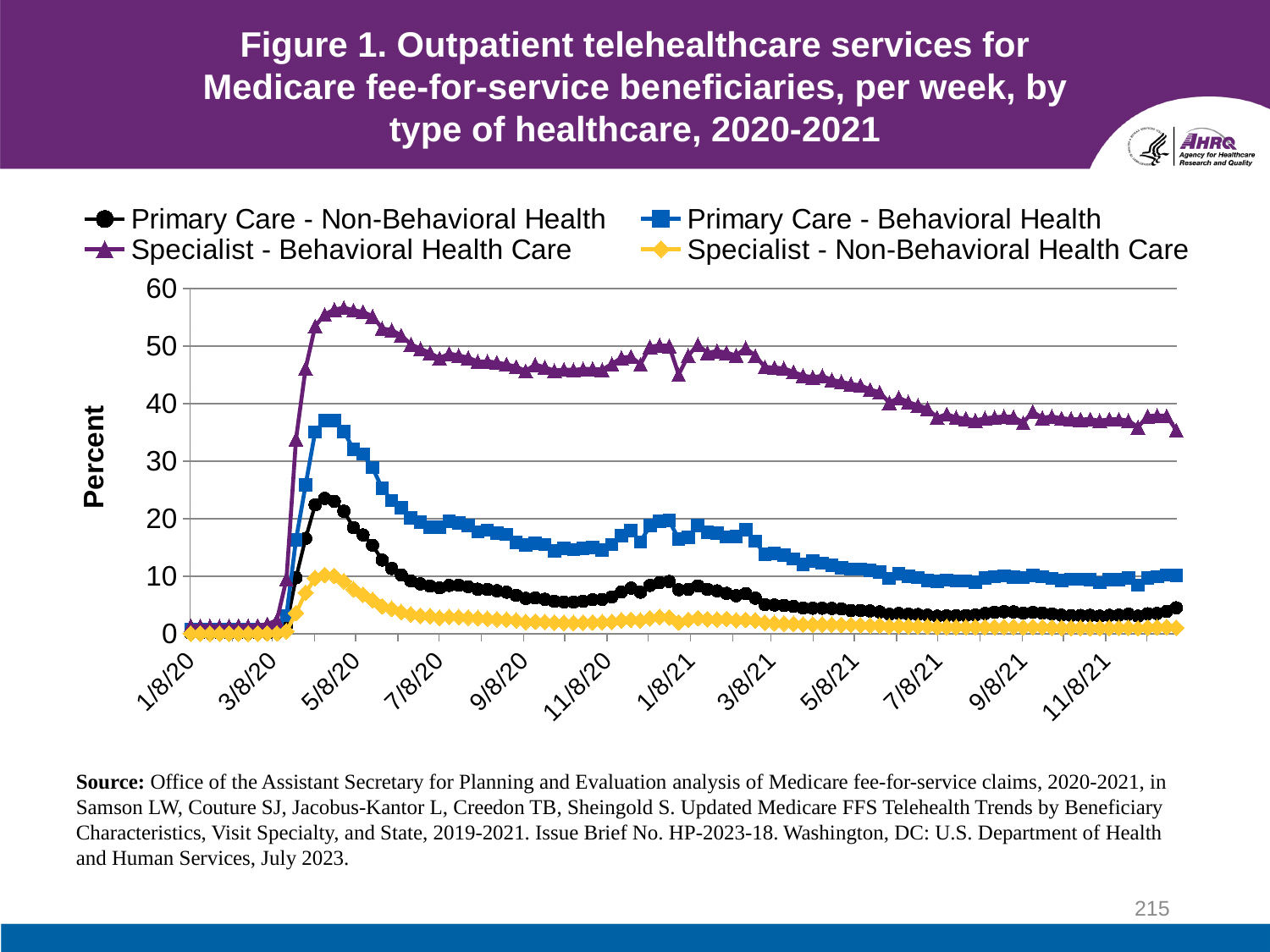
From its peak in spring 2020 to the end of 2021, do the values for Specialist - Behavioral Health Care rise or fall overall? fall Which series has the lowest values from mid-2020 through the end of 2021? Specialist - Non-Behavioral Health Care What is the label on the vertical axis? Percent Is the peak value for Primary Care - Behavioral Health greater or less than 30? greater Which series has the highest values across the whole period shown? Specialist - Behavioral Health Care Is the peak value for Specialist - Non-Behavioral Health Care greater or less than 20? less Is the value for Primary Care - Non-Behavioral Health at 1/8/20 greater or less than 10? less Around 1/8/21, which is larger: Primary Care - Behavioral Health or Primary Care - Non-Behavioral Health? Primary Care - Behavioral Health What is the highest value shown on the vertical axis? 60 What kind of chart is shown on the slide? line chart How many series does the legend list? 4